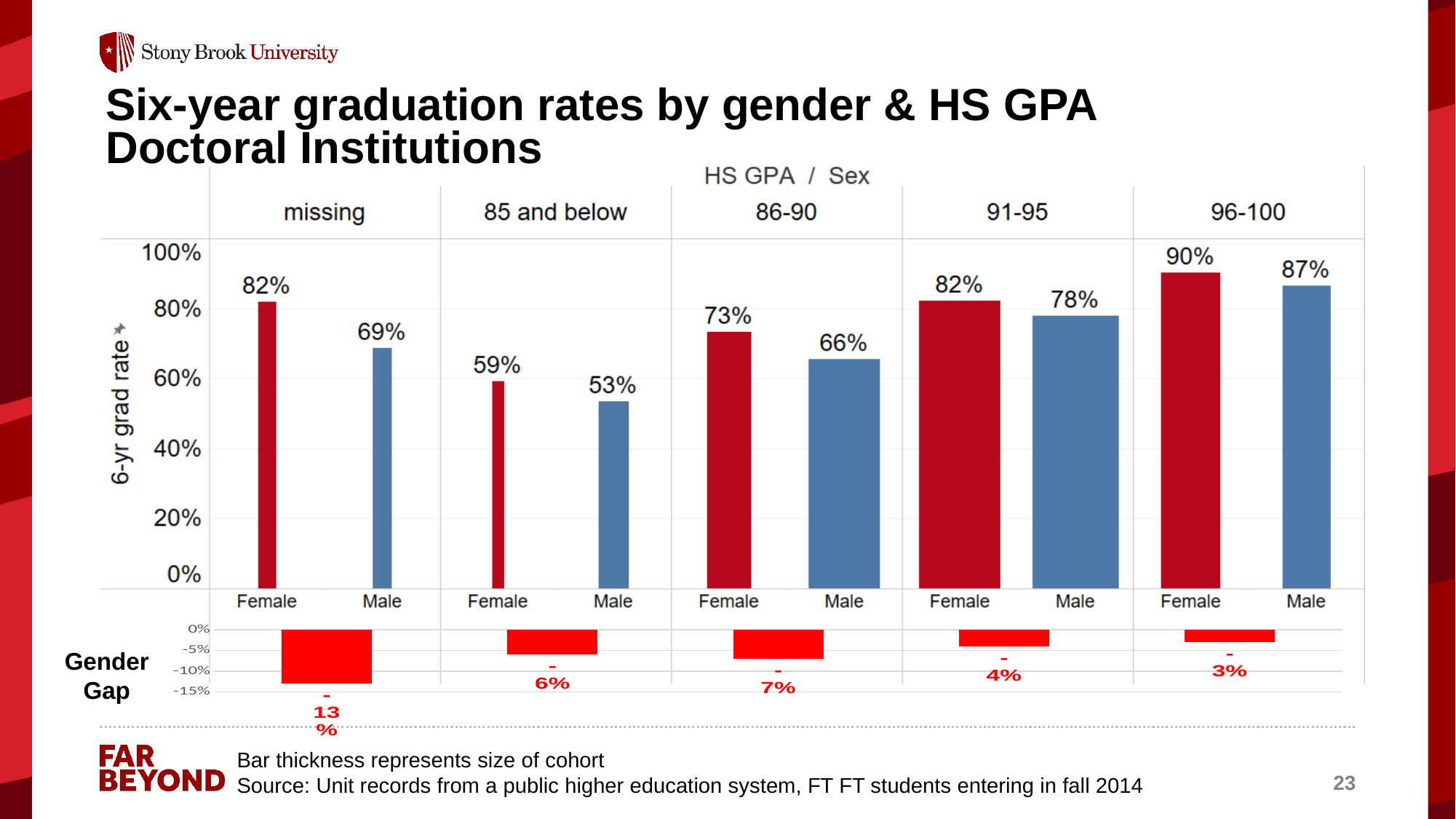
In the main graduation rate chart, which HS GPA group has the lowest female graduation rate? 85 and below In the Gender Gap chart, which HS GPA group has the smallest gender gap in magnitude? 96-100 How many HS GPA groups are shown in the main graduation rate chart? 5 In the main graduation rate chart, what is the difference between the female and male graduation rates in the 86-90 HS GPA group? 7% In the main graduation rate chart, what is the six-year graduation rate for females with a HS GPA of 96-100? 90% In the main graduation rate chart, what is the six-year graduation rate for males with a HS GPA of 85 and below? 53% In the Gender Gap chart, what is the gender gap for the 'missing' HS GPA group? -13% In the main graduation rate chart, what does bar thickness represent? Size of cohort In the main graduation rate chart, which bar shows the highest graduation rate overall? Female, 96-100 What type of chart is the main graduation rate chart? Bar chart In the main graduation rate chart, which is larger: the male rate for 91-95 or the female rate for 86-90? Male rate for 91-95 In the main graduation rate chart, what is the six-year graduation rate for males in the 'missing' HS GPA group? 69%